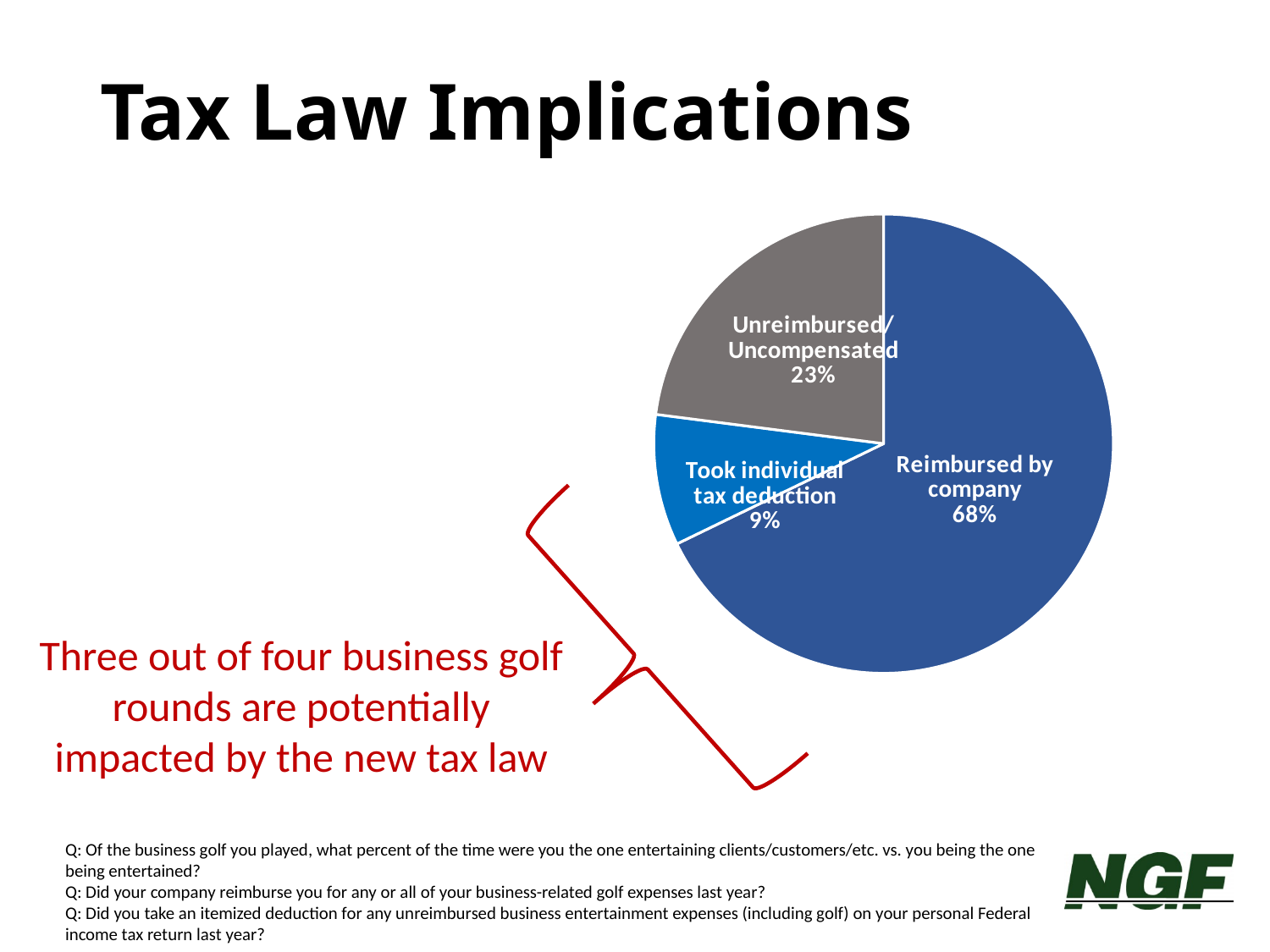
What colour is the 'Reimbursed by company' slice? dark blue What share of the pie is 'Took individual tax deduction'? 9% What share of the pie is 'Unreimbursed/Uncompensated'? 23% What is the combined share of 'Unreimbursed/Uncompensated' and 'Took individual tax deduction'? 32% What is the difference in percentage points between 'Reimbursed by company' and 'Unreimbursed/Uncompensated'? 45 Which slice of the pie is the largest? Reimbursed by company What share of the pie is 'Reimbursed by company'? 68% What kind of chart is shown on the slide? pie chart Which is larger, 'Unreimbursed/Uncompensated' or 'Took individual tax deduction'? Unreimbursed/Uncompensated Which slice of the pie is the smallest? Took individual tax deduction What is the difference in percentage points between 'Unreimbursed/Uncompensated' and 'Took individual tax deduction'? 14 How many slices does the pie chart have? 3